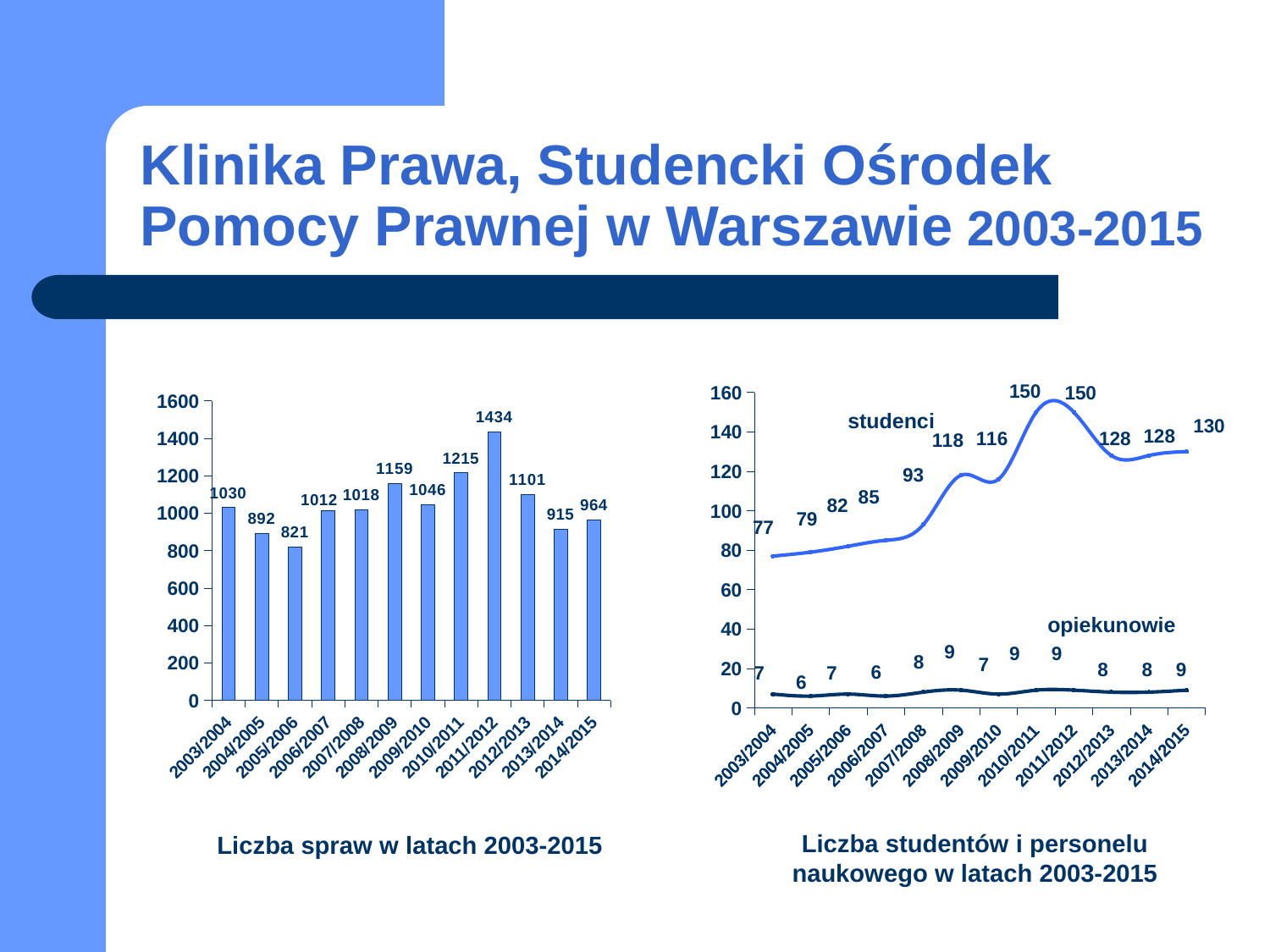
In the chart titled 'Liczba spraw w latach 2003-2015', what is the value for 2011/2012? 1434 In the chart titled 'Liczba studentów i personelu naukowego w latach 2003-2015', how many series are plotted? 2 In the chart titled 'Liczba spraw w latach 2003-2015', which year has the highest value? 2011/2012 In the chart titled 'Liczba spraw w latach 2003-2015', which year has the lowest value? 2005/2006 In the chart titled 'Liczba spraw w latach 2003-2015', how many years are shown on the x axis? 12 In the chart titled 'Liczba studentów i personelu naukowego w latach 2003-2015', what is the difference between studenci and opiekunowie in 2010/2011? 141 What kind of chart is the one titled 'Liczba spraw w latach 2003-2015'? bar chart In the chart titled 'Liczba studentów i personelu naukowego w latach 2003-2015', what is the value for studenci in 2007/2008? 93 In the chart titled 'Liczba studentów i personelu naukowego w latach 2003-2015', is the value for studenci in 2003/2004 larger or smaller than in 2014/2015? smaller In the chart titled 'Liczba studentów i personelu naukowego w latach 2003-2015', what is the value for opiekunowie in 2014/2015? 9 In the chart titled 'Liczba spraw w latach 2003-2015', what is the difference between the values for 2011/2012 and 2012/2013? 333 What kind of chart is the one titled 'Liczba studentów i personelu naukowego w latach 2003-2015'? line chart